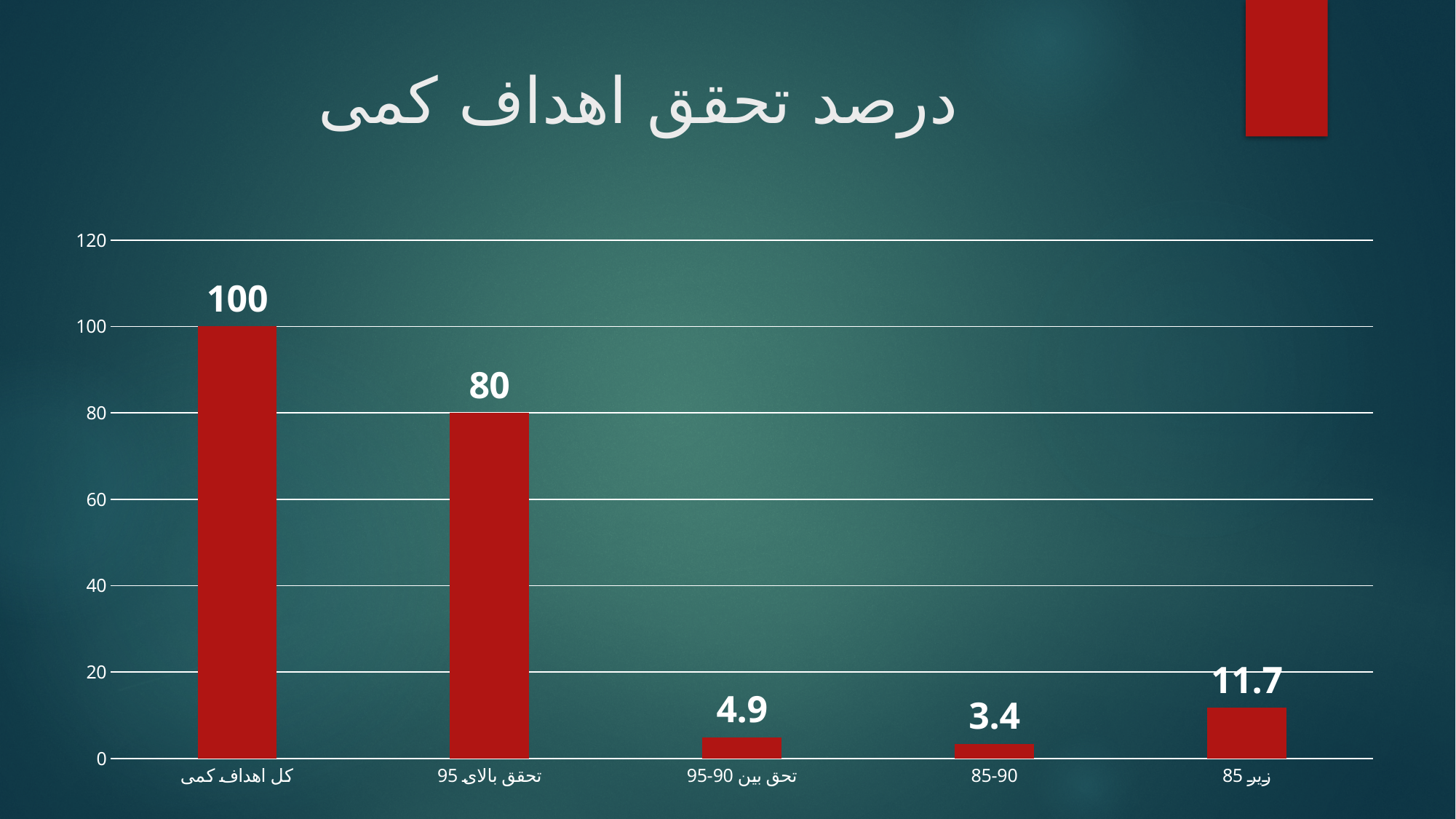
Which is larger, the value for "زیر 85" or the value for "تحق بین 90-95"? زیر 85 What is the difference between the values for "کل اهداف کمی" and "تحقق بالای 95"? 20 Which category has the highest value? کل اهداف کمی What is the value for the category "تحقق بالای 95"? 80 How many categories are shown on the x axis? 5 What is the value for the category "زیر 85"? 11.7 What is the title of the chart? درصد تحقق اهداف کمی What is the value for the category "کل اهداف کمی"? 100 What kind of chart is shown on the slide? bar chart Which category has the lowest value? 85-90 What is the value for the category "85-90"? 3.4 What is the difference between the values for "زیر 85" and "85-90"? 8.3